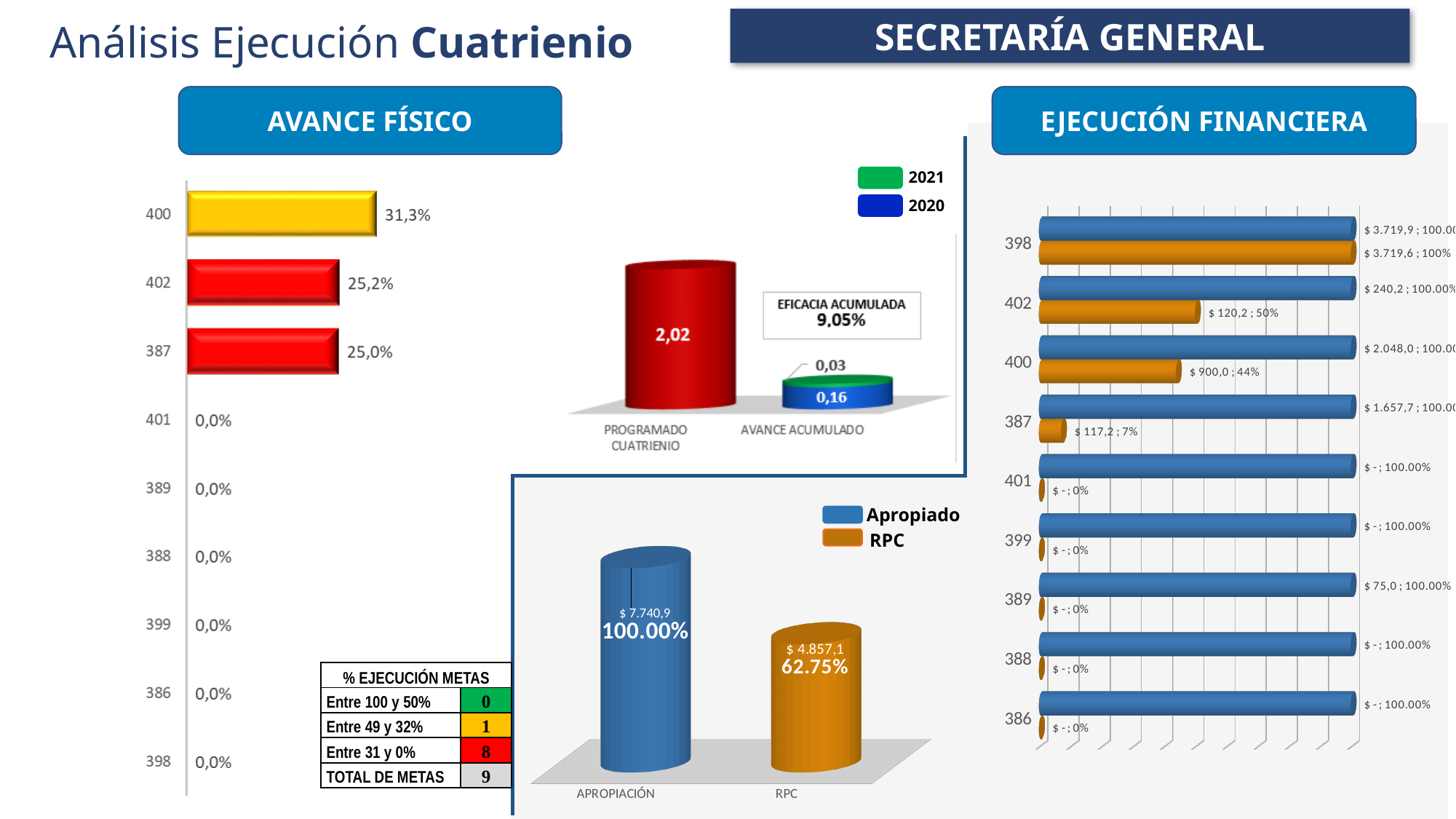
How many categories are shown in the AVANCE FÍSICO chart? 9 In the PROGRAMADO CUATRIENIO / AVANCE ACUMULADO chart, what is the value for PROGRAMADO CUATRIENIO? 2,02 What type of chart is the EJECUCIÓN FINANCIERA chart? Bar chart In the APROPIACIÓN / RPC chart at the bottom centre, what amount is shown for APROPIACIÓN? $ 7.740,9 In the AVANCE FÍSICO chart, which category has the highest value? 400 In the EJECUCIÓN FINANCIERA chart, which is larger for category 400: the Apropiado bar or the RPC bar? Apropiado In the AVANCE FÍSICO chart, what is the value for category 400? 31,3% In the APROPIACIÓN / RPC chart at the bottom centre, what percentage is shown for RPC? 62.75% In the AVANCE FÍSICO chart, what is the difference between the values for 402 and 387? 0,2% How many series does the legend of the PROGRAMADO CUATRIENIO / AVANCE ACUMULADO chart list? 2 In the PROGRAMADO CUATRIENIO / AVANCE ACUMULADO chart, what is the 2020 value for AVANCE ACUMULADO? 0,16 In the EJECUCIÓN FINANCIERA chart, what is the RPC value for category 402? $ 120,2 ; 50%